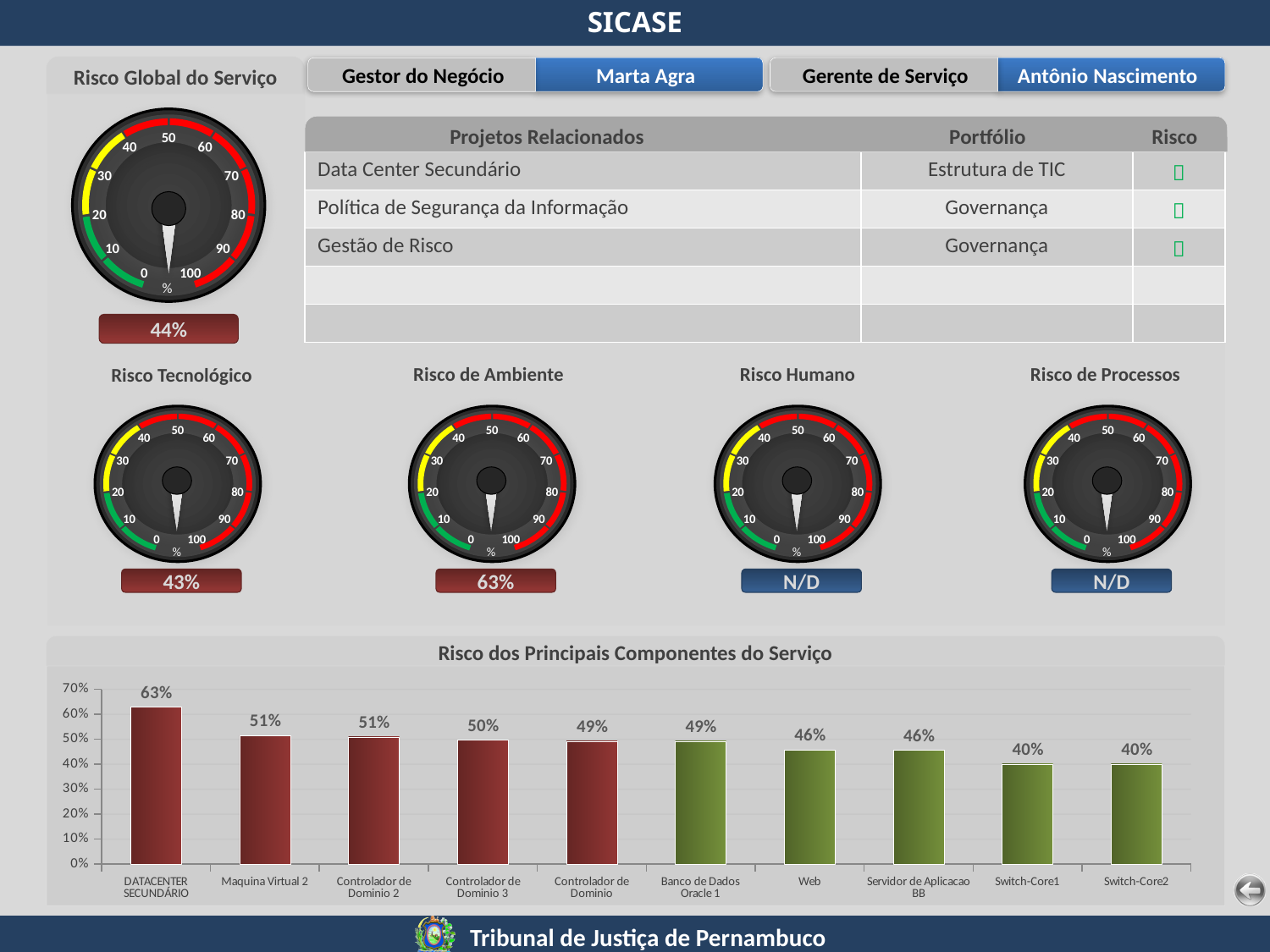
How many components are shown in the 'Risco dos Principais Componentes do Serviço' chart? 10 In the 'Risco dos Principais Componentes do Serviço' chart, which component has the highest value? DATACENTER SECUNDÁRIO In the 'Risco dos Principais Componentes do Serviço' chart, which is larger: Controlador de Dominio 3 or Servidor de Aplicacao BB? Controlador de Dominio 3 In the 'Risco dos Principais Componentes do Serviço' chart, what is the value for DATACENTER SECUNDÁRIO? 63% What value is shown below the 'Risco Humano' gauge? N/D In the 'Risco dos Principais Componentes do Serviço' chart, what is the value for Switch-Core2? 40% In the 'Risco dos Principais Componentes do Serviço' chart, what is the difference between DATACENTER SECUNDÁRIO and Maquina Virtual 2? 12% What value does the 'Risco de Ambiente' gauge show? 63% In the 'Risco dos Principais Componentes do Serviço' chart, what is the value for Web? 46% What value does the 'Risco Global do Serviço' gauge show? 44% What kind of chart is 'Risco dos Principais Componentes do Serviço'? Bar chart In the 'Risco dos Principais Componentes do Serviço' chart, do the values rise or fall from left to right? Fall